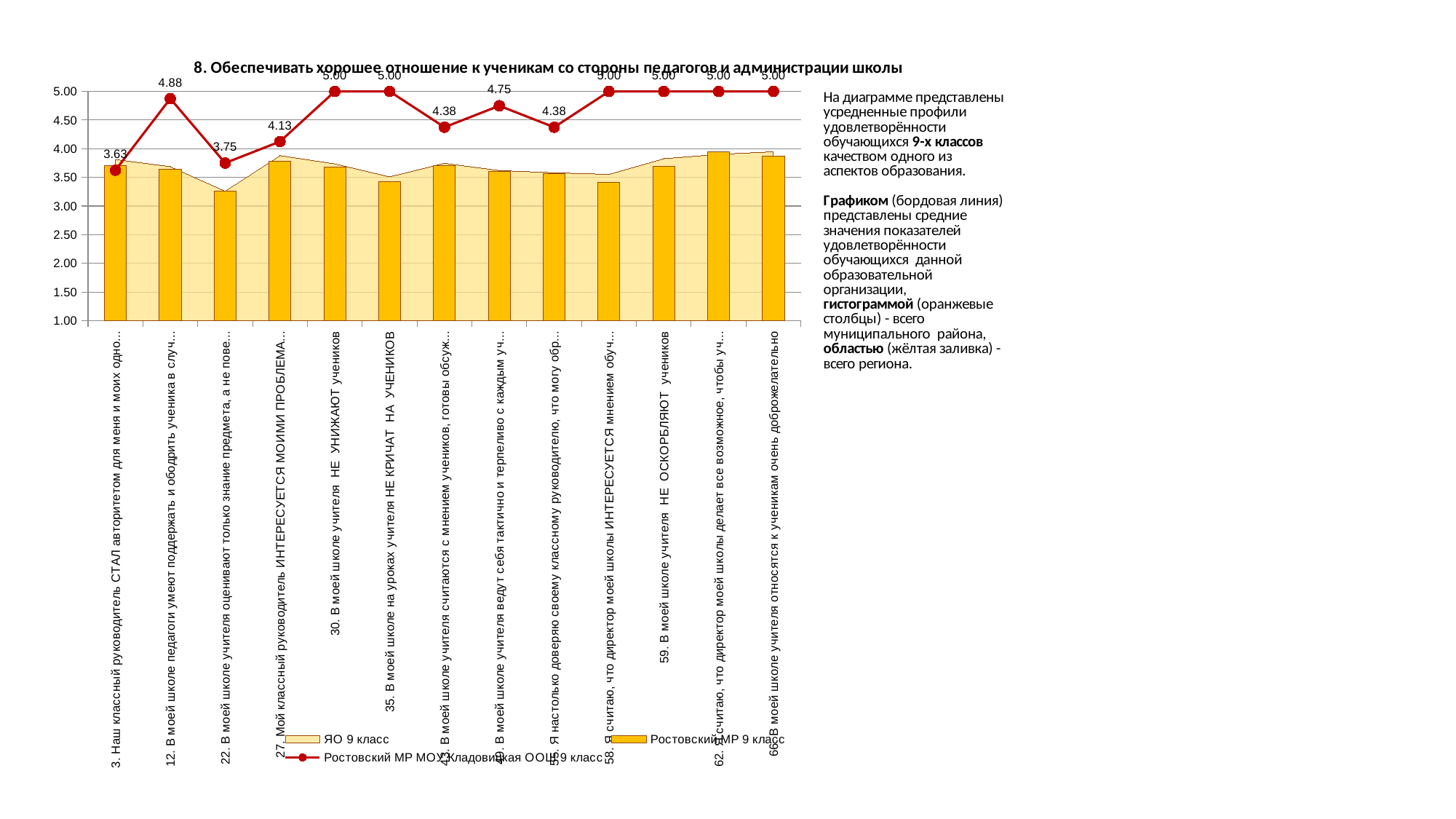
What value does the red line show for the category beginning "12. В моей школе педагоги умеют поддержать..."? 4.88 What is the difference between the red line values for item 12 (4.88) and item 3 (3.63)? 1.25 What value does the red line show for the category "35. В моей школе на уроках учителя НЕ КРИЧАТ НА УЧЕНИКОВ"? 5.00 What value does the red line show for the first category (item 3, "Наш классный руководитель СТАЛ авторитетом...")? 3.63 How many categories are plotted along the x axis? 13 How many series does the legend list? 3 Which has the higher red line value: item 12 ("В моей школе педагоги умеют поддержать...") or item 22 ("В моей школе учителя оценивают только знание предмета...")? Item 12 Which category has the lowest value on the red line? Item 3 (Наш классный руководитель СТАЛ авторитетом...), 3.63 Is the orange bar (Ростовский МР 9 класс) for item 22 ("В моей школе учителя оценивают только знание предмета...") greater or less than 3.50? less Which series is drawn as the red line with markers, according to the legend? Ростовский МР МОУ Кладовицкая ООШ 9 класс What value does the red line show for the category "30. В моей школе учителя НЕ УНИЖАЮТ учеников"? 5.00 Is the orange bar (Ростовский МР 9 класс) for "66. В моей школе учителя относятся к ученикам очень доброжелательно" greater or less than 3.50? greater